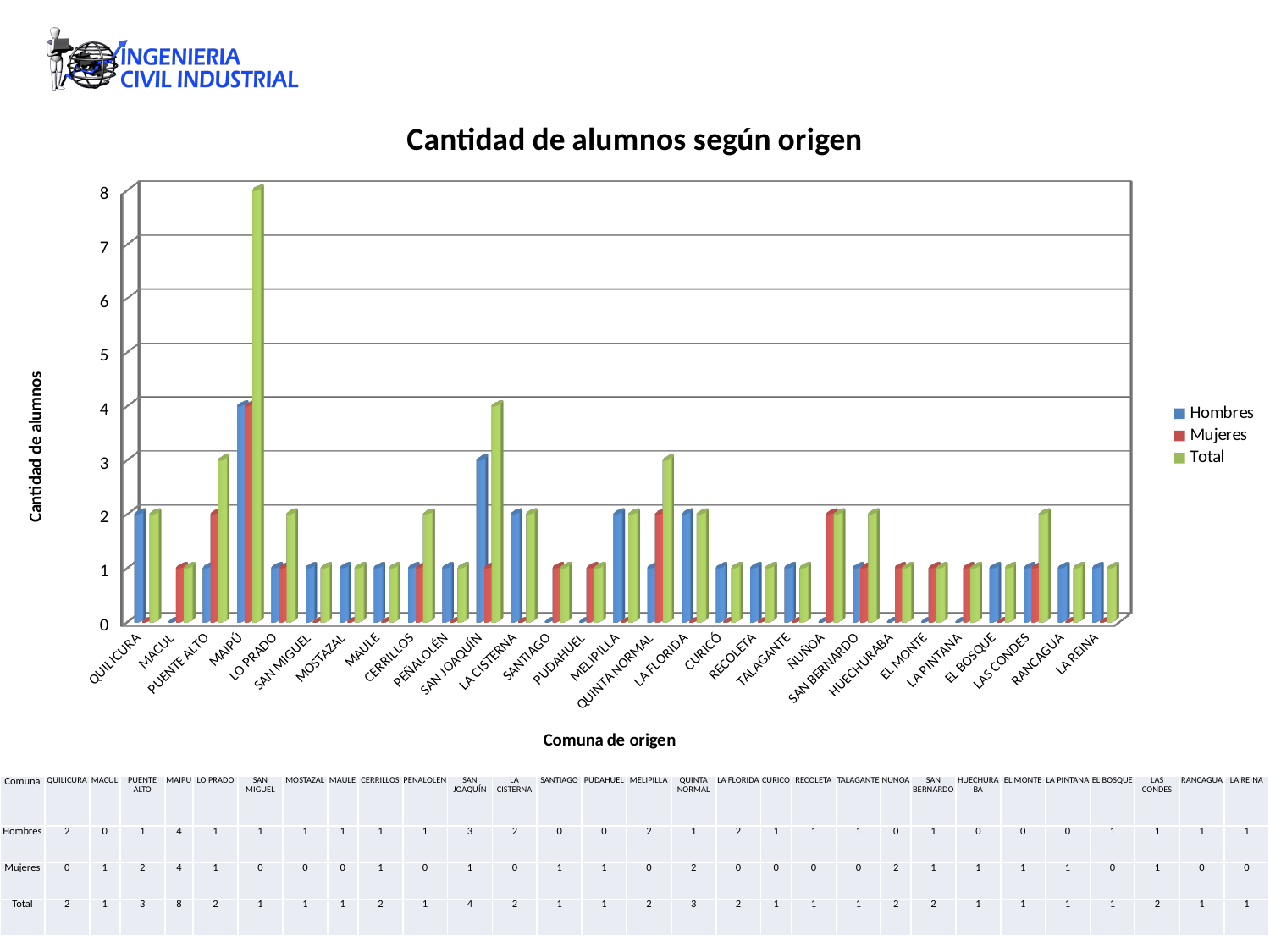
Is the Total value for MAIPÚ greater or less than 6? greater Which is larger for QUILICURA, the Hombres value or the Mujeres value? Hombres What is the label of the vertical axis? Cantidad de alumnos What is the title of the chart? Cantidad de alumnos según origen What is the difference between the Total for MAIPÚ and the Total for SAN JOAQUÍN? 4 How many comunas are shown on the x axis? 29 How many series does the legend list? 3 What type of chart is shown on the slide? bar chart What is the Mujeres value for QUINTA NORMAL? 2 What is the Hombres value for SAN JOAQUÍN? 3 What is the Total value for MAIPÚ? 8 Which comuna has the highest Total value? MAIPÚ